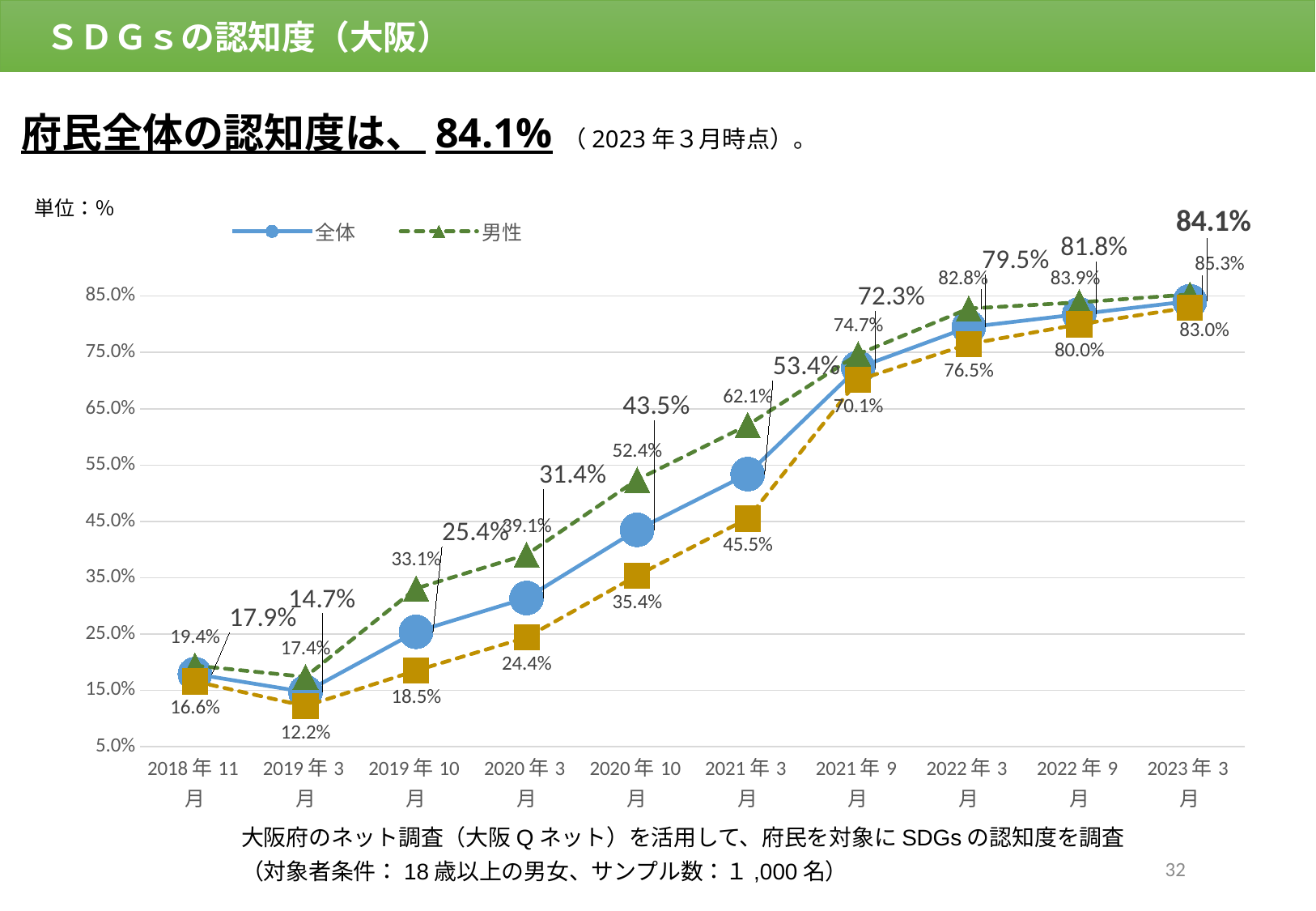
What is the value of 全体 in 2020年10月? 43.5% At which x-axis point is the 男性 series highest? 2023年3月 How many time points are shown on the x axis? 10 Does the 全体 series generally rise or fall from 2019年3月 to 2023年3月? rise What is the difference between the 男性 value and the 全体 value in 2020年3月? 7.7% What kind of chart is shown on the slide? line chart How many series does the legend list? 2 What is the value of 男性 in 2019年10月? 33.1% What is the value of 男性 in 2021年3月? 62.1% Which is larger in 2021年9月, the 全体 value or the 男性 value? 男性 At which x-axis point is the 全体 series lowest? 2019年3月 What is the value of 全体 in 2023年3月? 84.1%